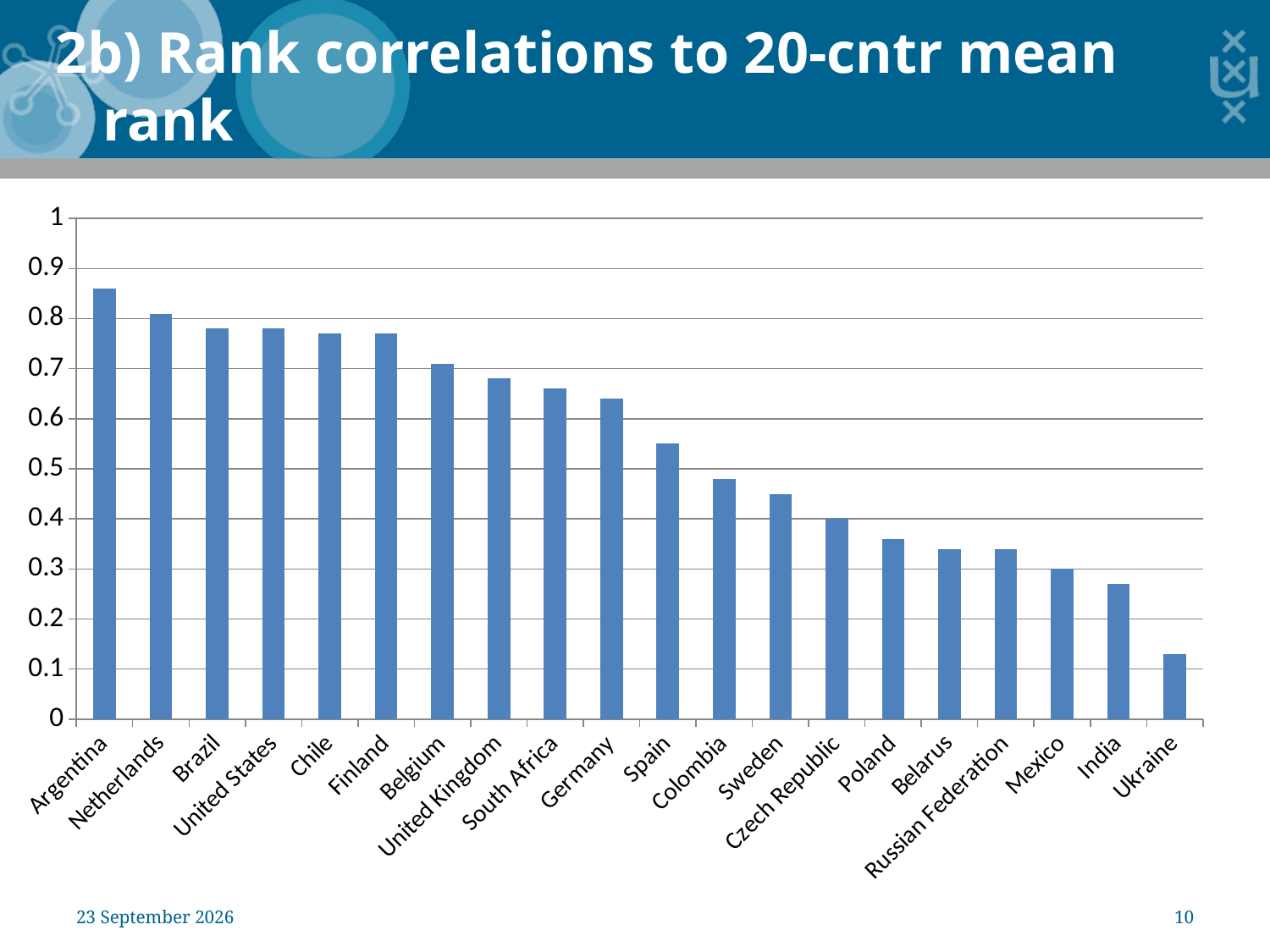
What is the title of the slide containing the chart? 2b) Rank correlations to 20-cntr mean rank Which country has the lowest rank correlation in the chart? Ukraine What type of chart is shown on the slide? bar chart Which has the larger value, Spain or Germany? Germany Is the value for Sweden greater or less than 0.5? less Do the values rise or fall moving from left to right along the x axis? fall Is the value for Ukraine greater or less than 0.2? less Is the value for Argentina greater or less than 0.8? greater How many countries are shown on the x axis of the chart? 20 Which country has the highest rank correlation in the chart? Argentina